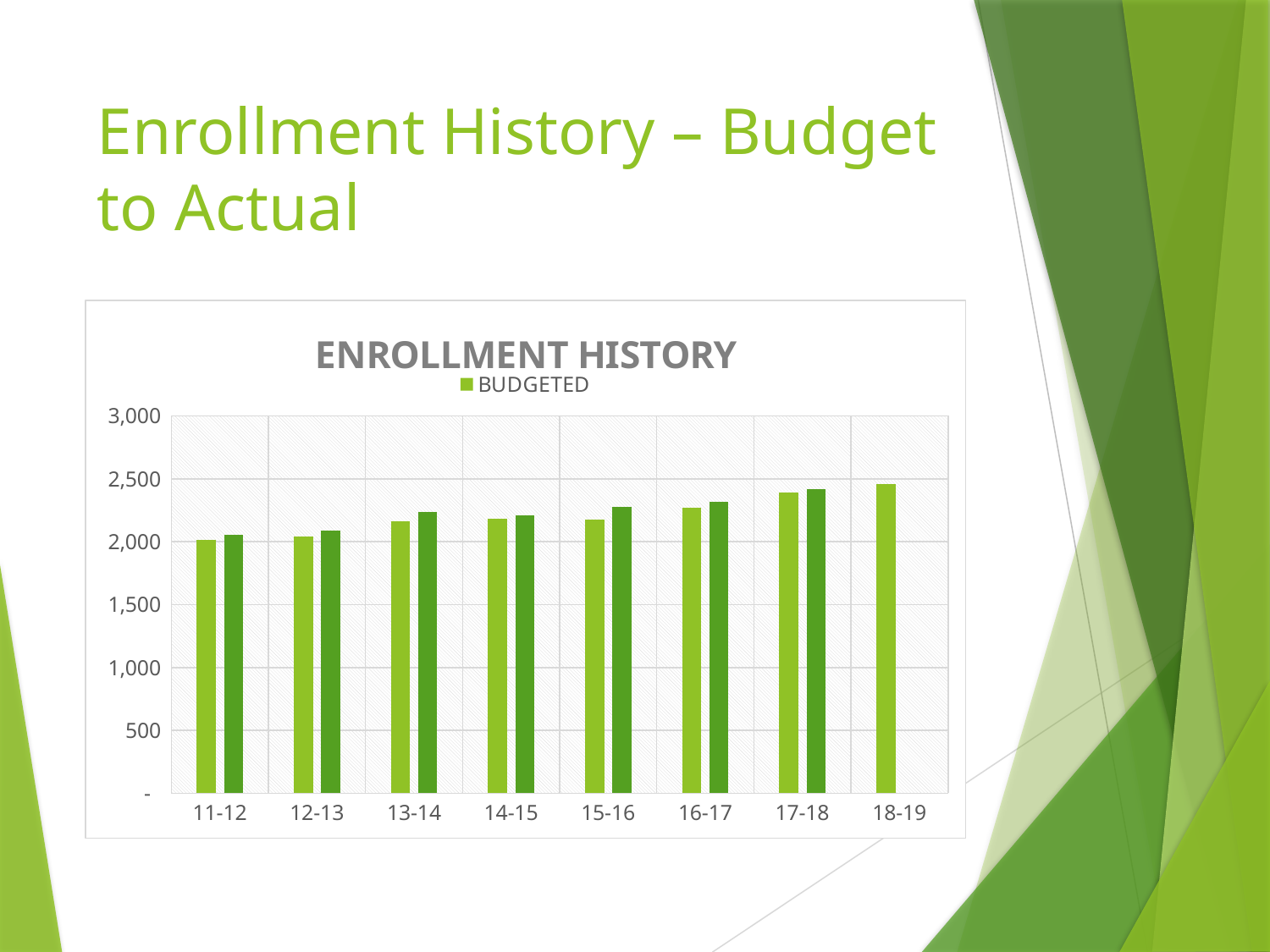
Which school year has the lowest BUDGETED bar? 11-12 What series name appears in the chart legend? BUDGETED Do the BUDGETED values generally rise or fall from 11-12 to 18-19? rise Is the BUDGETED value for 18-19 greater or less than 2,000? greater How many series does the chart legend list? 1 Which school year has the highest BUDGETED bar? 18-19 What is the title of the chart? ENROLLMENT HISTORY Is the BUDGETED value for 14-15 greater or less than 1,500? greater Is the BUDGETED value for 11-12 greater or less than 2,500? less What kind of chart is shown on the slide? bar chart How many school-year categories are shown on the x axis? 8 Which is larger, the BUDGETED value for 11-12 or for 18-19? 18-19